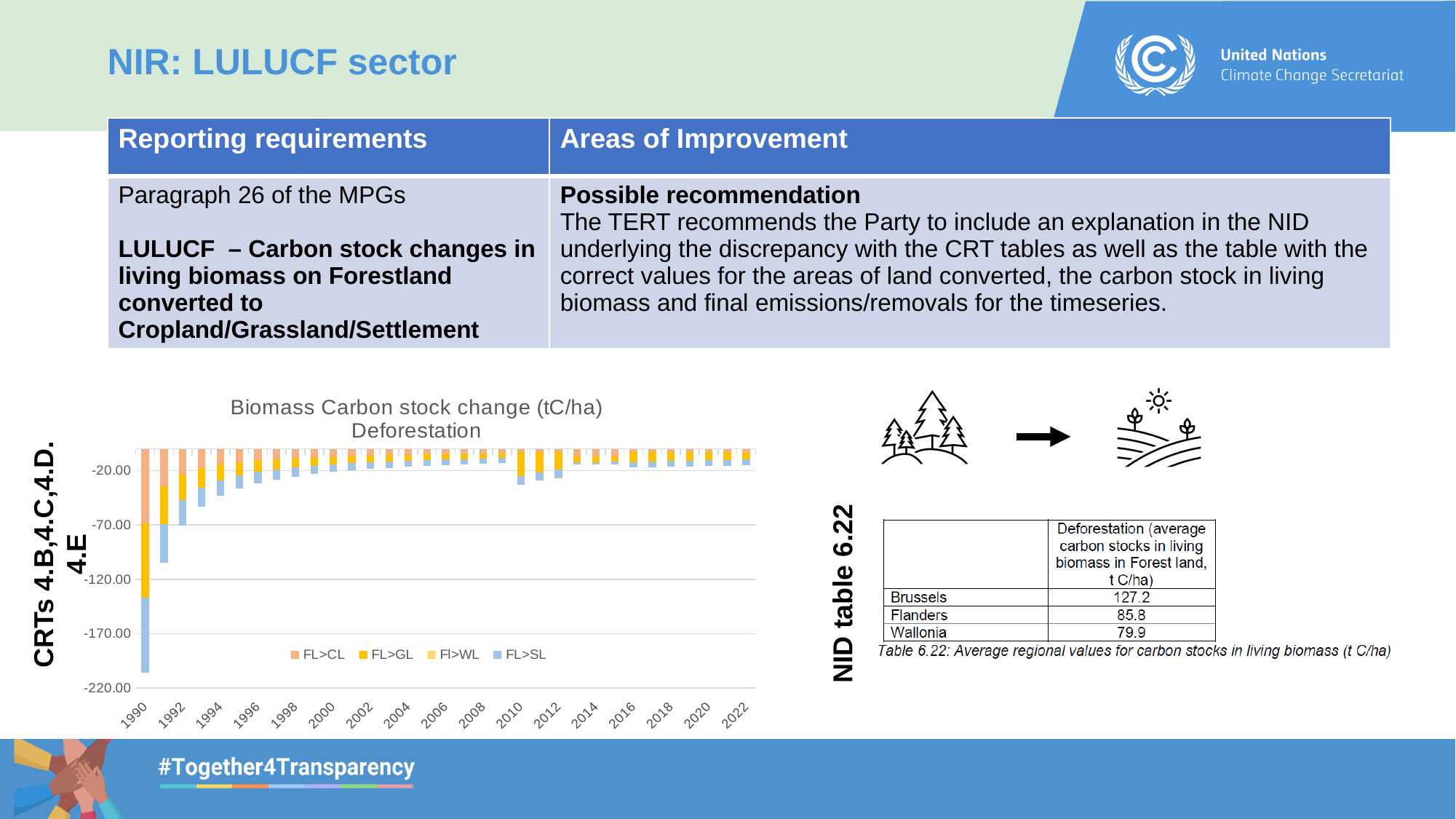
In the 'Biomass Carbon stock change' chart, is the total for 2010 greater or less than -70.00? greater In the 'Biomass Carbon stock change' chart, is the total for 1990 greater or less than -170.00? less What are the legend entries of the 'Biomass Carbon stock change' chart? FL>CL, FL>GL, Fl>WL, FL>SL What type of chart is shown under the title 'Biomass Carbon stock change (tC/ha) Deforestation'? Stacked bar chart In the 'Biomass Carbon stock change' chart, is the total for 1991 greater or less than -70.00? less What is the title of the chart on the slide? Biomass Carbon stock change (tC/ha) Deforestation In the 'Biomass Carbon stock change' chart, which bar extends further below zero, 1990 or 2022? 1990 How many year labels are shown on the x axis of the 'Biomass Carbon stock change' chart? 17 In the 'Biomass Carbon stock change' chart, do the bar totals generally move closer to zero or further from zero from 1990 to 2022? Closer to zero In the 'Biomass Carbon stock change' chart, which year has the bar extending furthest below zero? 1990 How many series does the legend of the 'Biomass Carbon stock change' chart list? 4